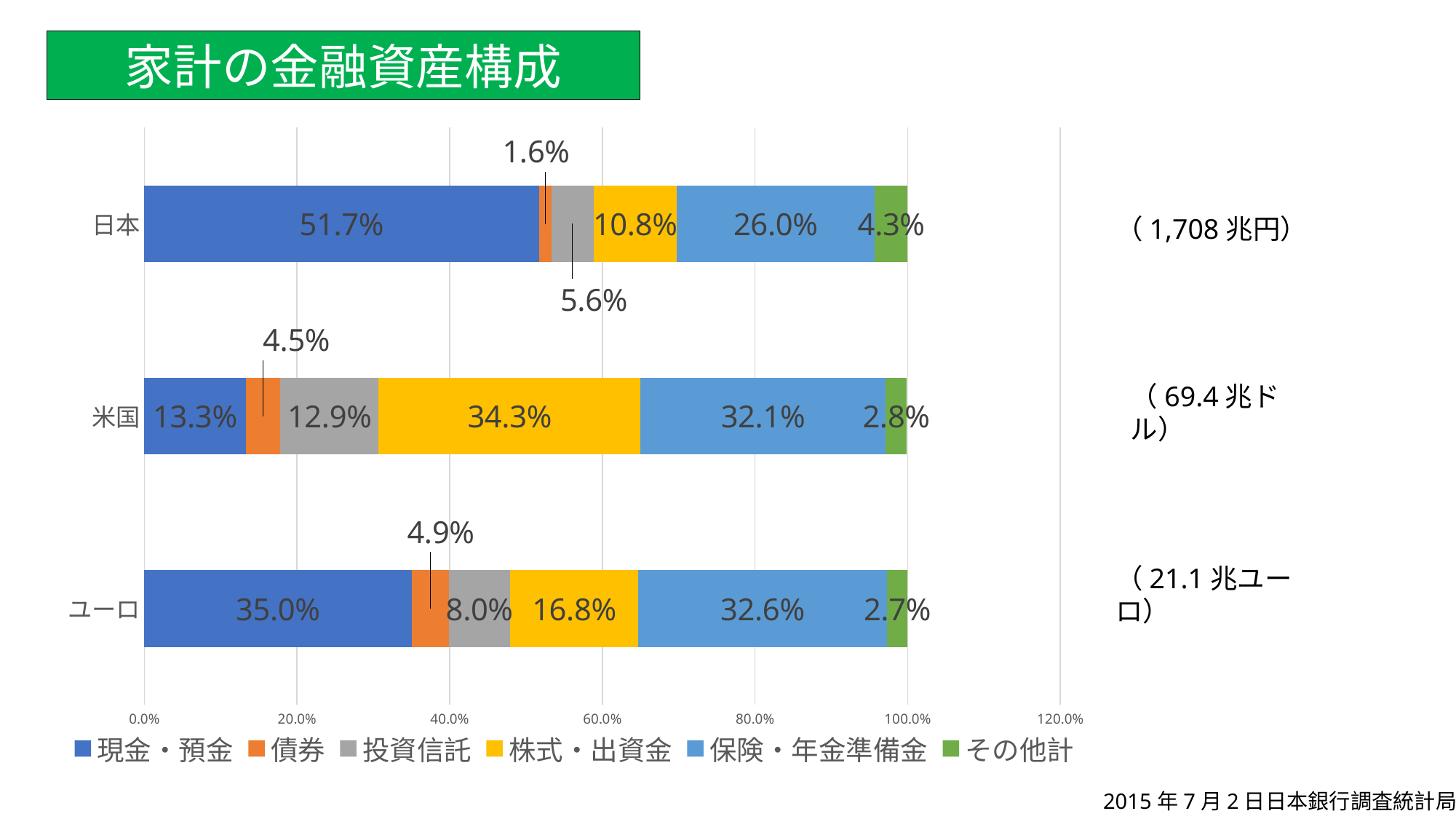
What is the title of the slide? 家計の金融資産構成 What is the difference between the 現金・預金 values for 日本 and 米国? 38.4% Which is larger, the 投資信託 value for 米国 or for ユーロ? 米国 What is the value for 債券 in the 日本 bar? 1.6% What is the value for 保険・年金準備金 in the ユーロ bar? 32.6% How many series does the legend list? 6 What kind of chart is shown on the slide? Stacked bar chart What is the value for 現金・預金 in the 日本 bar? 51.7% Which category has the lowest value for 株式・出資金? 日本 Which category has the highest value for 現金・預金? 日本 What is the value for 株式・出資金 in the 米国 bar? 34.3% How many categories are shown on the chart? 3